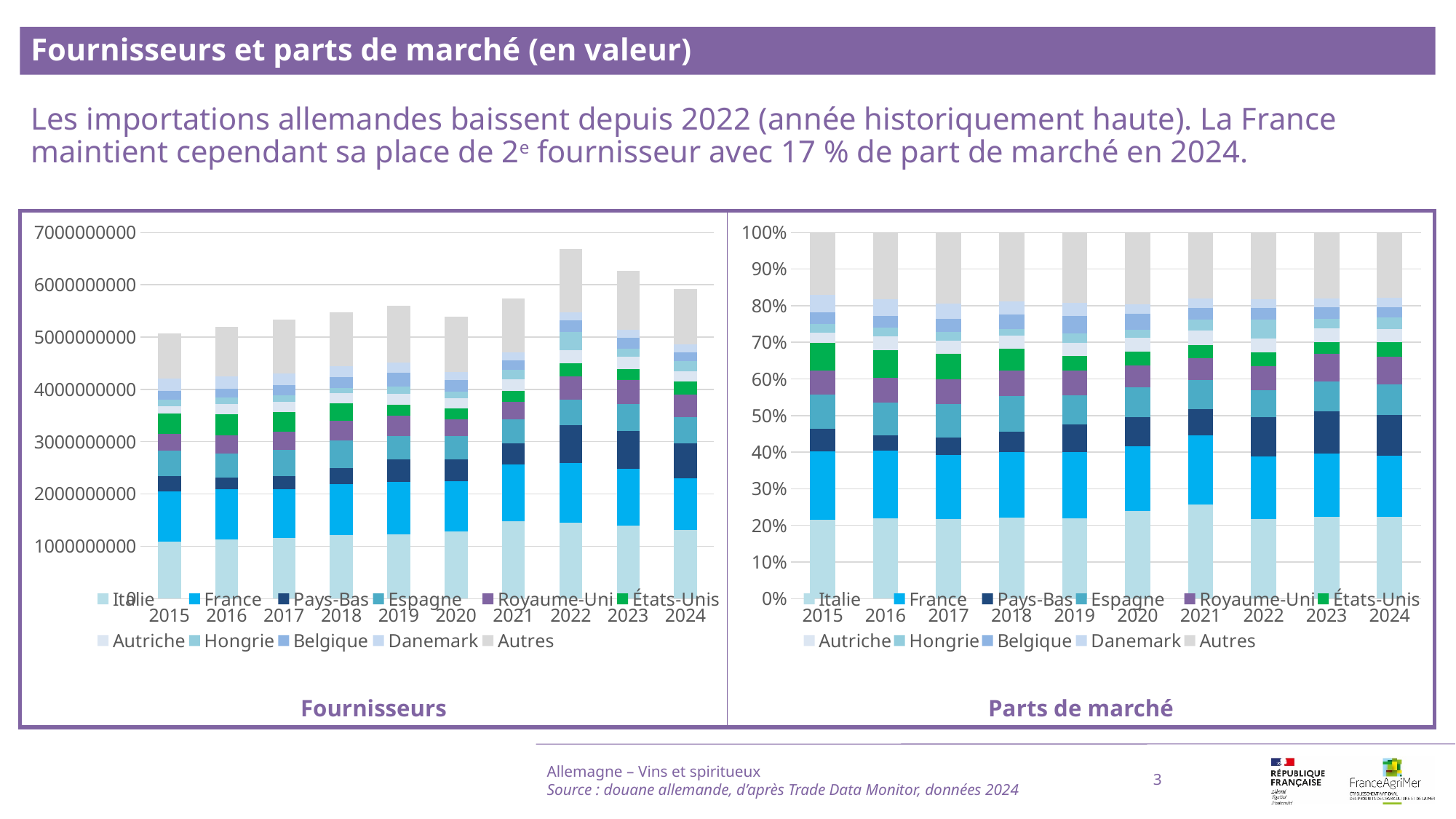
In the "Parts de marché" chart, is the share for Italie in 2015 greater or less than 30%? less How many years are shown on the x axis of the "Fournisseurs" chart? 10 In the "Fournisseurs" chart, is the total for 2024 greater or less than 6000000000? less Which series is listed first in the legend of the "Fournisseurs" chart? Italie What kind of chart is the "Fournisseurs" chart on the left? stacked bar chart In the "Fournisseurs" chart, which year has the highest total bar? 2022 How many series does the legend of the "Parts de marché" chart list? 11 In the "Fournisseurs" chart, is the total for 2022 greater or less than 6000000000? greater In the "Fournisseurs" chart, do the total bars rise or fall from 2015 to 2022? rise In the "Fournisseurs" chart, which year has the lowest total bar? 2015 In the "Fournisseurs" chart, which total bar is taller, 2022 or 2023? 2022